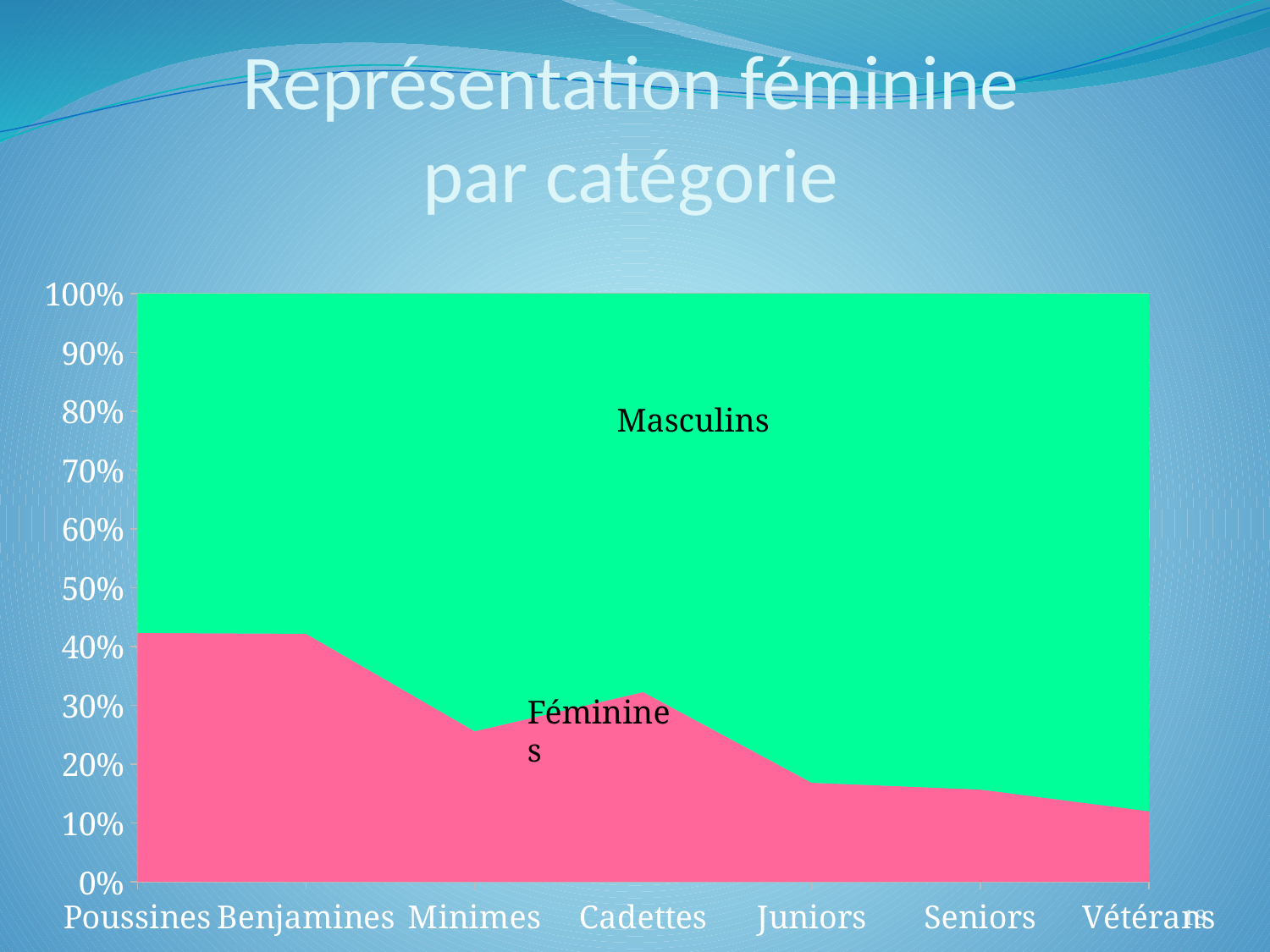
Is the Féminines share for Minimes greater or less than 30%? less How many series does the chart show? 2 How many categories are shown along the x axis of the chart? 7 Is the Féminines share for Poussines greater or less than 30%? greater Is the Féminines share for Cadettes greater or less than 40%? less Which category has the larger Féminines share, Minimes or Cadettes? Cadettes Which category has the lowest Féminines share? Vétérans Does the Féminines share generally rise or fall from Poussines to Vétérans? Fall Which colour represents the Féminines series in the chart? Pink What is the title of the chart on the slide? Représentation féminine par catégorie What kind of chart is shown on the slide? Stacked area chart